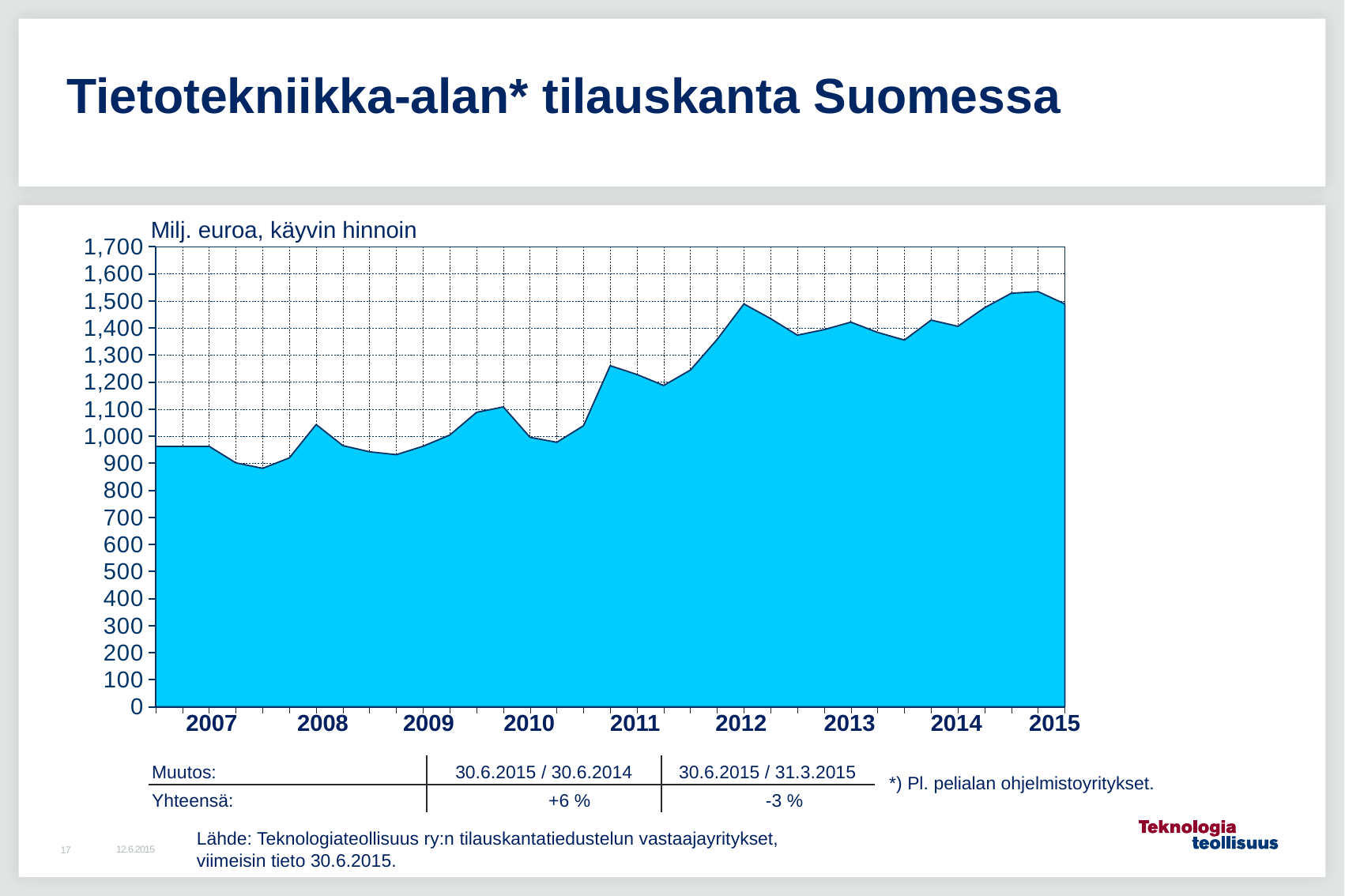
What unit is given above the chart's y-axis? Milj. euroa, käyvin hinnoin Which is larger, the value at 2007 or the value at 2015? 2015 Is the value at the start of 2007 greater or less than 1,000? less Is the value at 2015 greater or less than 1,400? greater Is the value at 2011 greater or less than 1,200? greater What kind of chart is shown on the slide? area chart According to the table below the chart, what is the change for 30.6.2015 / 30.6.2014? +6 % What is the highest value shown on the y-axis of the chart? 1,700 How many years are labelled on the x-axis of the chart? 9 Overall, does the order backlog rise or fall from 2007 to 2015? rise In which year does the chart reach its lowest value? 2007